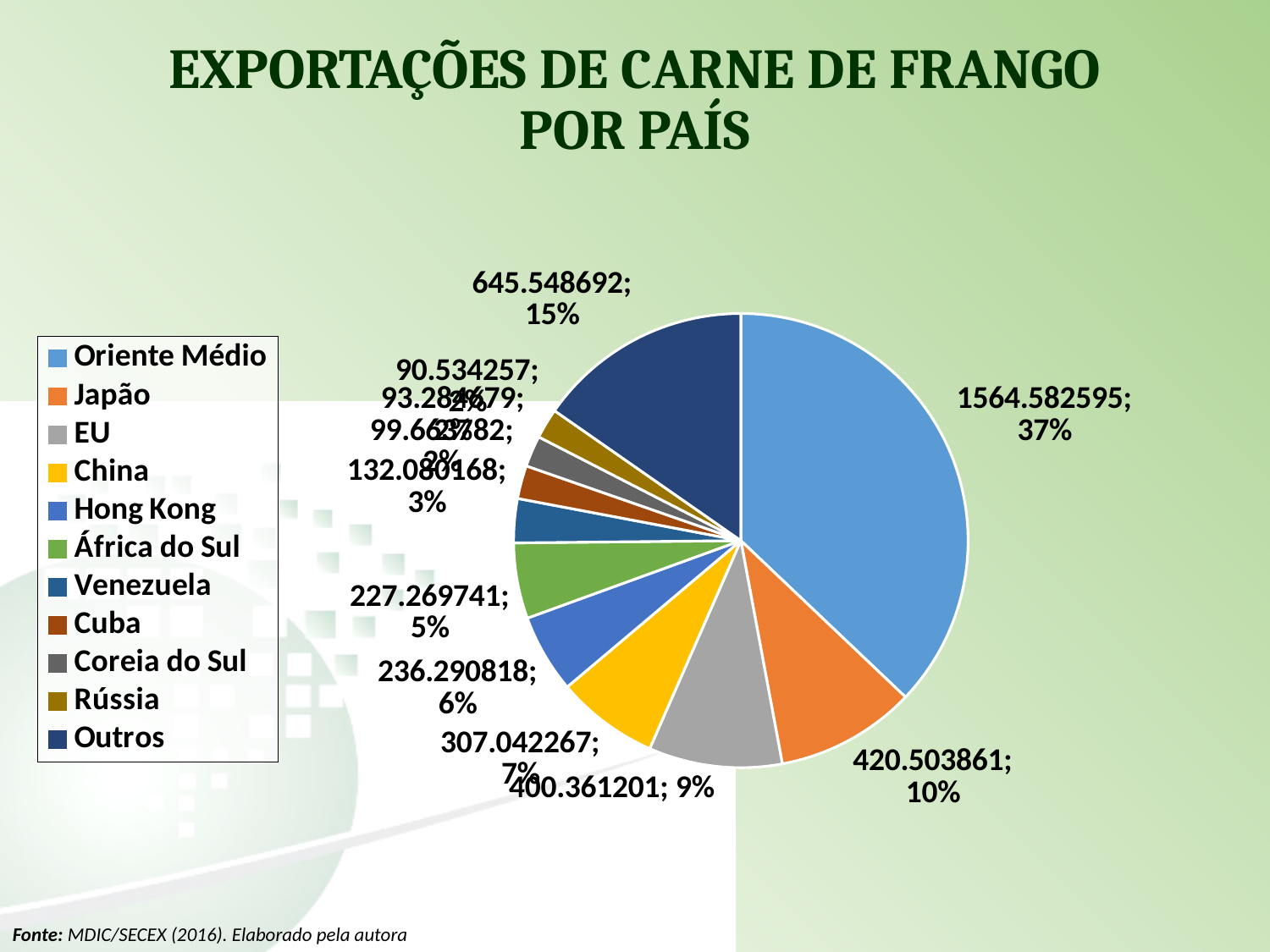
What is the value shown for China? 307.042267 What share of the pie does Oriente Médio account for? 37% What share of the pie does Hong Kong account for? 6% By how many percentage points does the share of Oriente Médio exceed the share of Outros? 22% What kind of chart is shown on the slide? pie chart What is the value shown for Venezuela? 132.080168 How many categories does the pie chart show? 11 What share of the pie does Outros account for? 15% Which category has the largest slice of the pie? Oriente Médio Which slice is larger, Japão or EU? Japão What is the title of the chart? EXPORTAÇÕES DE CARNE DE FRANGO POR PAÍS What is the value shown for Japão? 420.503861